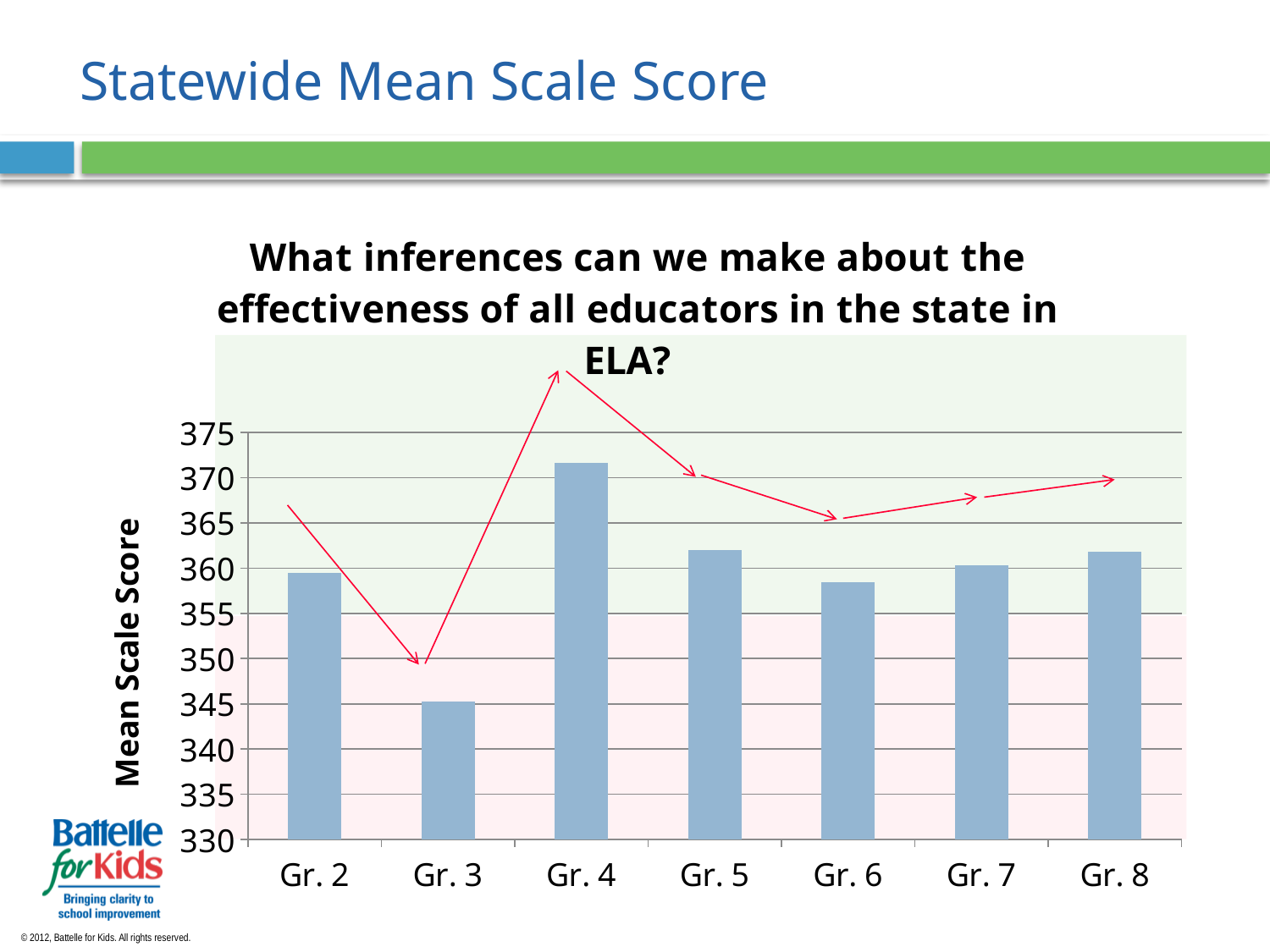
What is the label on the vertical axis of the chart? Mean Scale Score What kind of chart is shown on the slide? bar chart Is the value for Gr. 6 greater or less than 365? less Which grade has the lowest mean scale score? Gr. 3 Which grade has the highest mean scale score? Gr. 4 How many grade categories are plotted on the x axis? 7 Is the value for Gr. 4 greater or less than 370? greater Is the value for Gr. 2 greater or less than 355? greater Which is larger, the value for Gr. 5 or the value for Gr. 6? Gr. 5 Which is larger, the value for Gr. 3 or the value for Gr. 8? Gr. 8